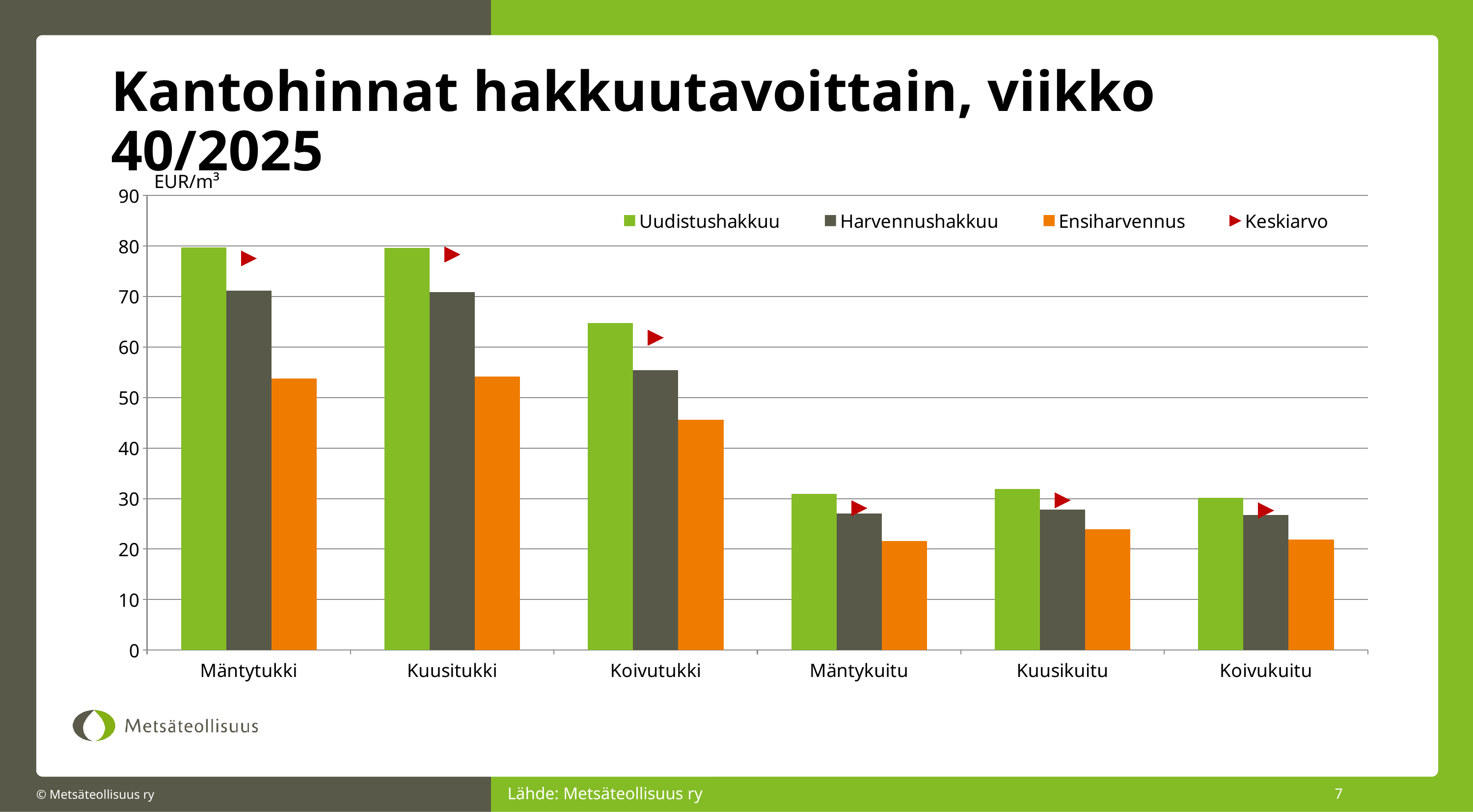
Which is larger, the Ensiharvennus value for Kuusikuitu or the Ensiharvennus value for Koivutukki? Koivutukki How many series does the chart legend list? 4 Is the Ensiharvennus value for Kuusitukki greater or less than 50? greater Is the Ensiharvennus value for Koivutukki greater or less than 50? less What kind of chart is shown on the slide? bar chart Is the Uudistushakkuu value for Mäntytukki greater or less than 70? greater Do the Uudistushakkuu values generally rise or fall from Mäntytukki to Koivukuitu along the x axis? fall What unit is shown above the vertical axis of the chart? EUR/m³ Which is larger, the Uudistushakkuu value for Koivutukki or the Uudistushakkuu value for Mäntykuitu? Koivutukki How many categories are shown on the x axis of the chart? 6